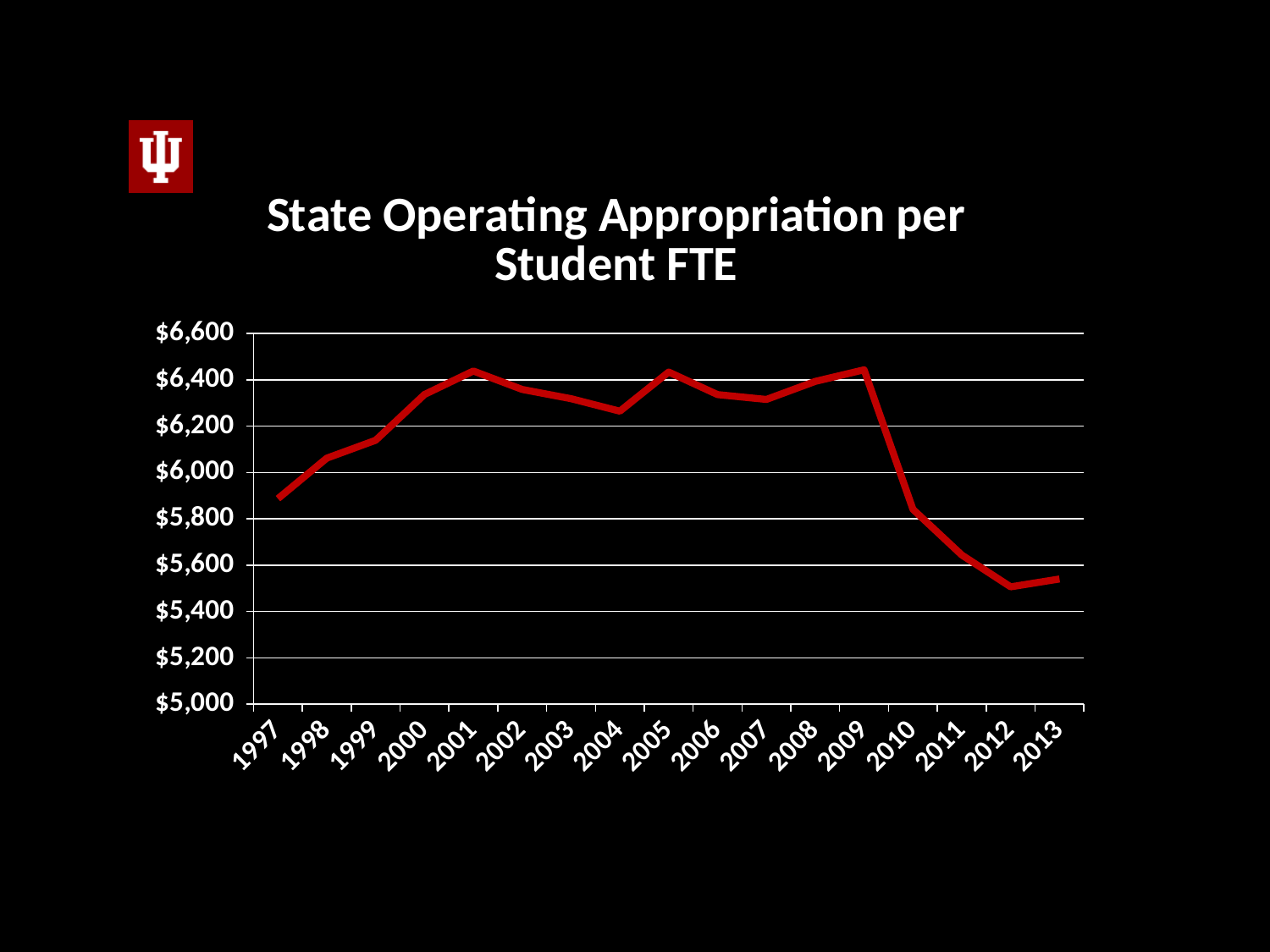
Is the value for 2012 greater or less than $5,600? less Is the value for 2010 greater or less than $6,000? less Is the value for 2001 greater or less than $6,400? greater Which year has the larger value, 1997 or 2001? 2001 What kind of chart is shown on the slide? line chart How many years are plotted along the x axis? 17 What is the title of the chart? State Operating Appropriation per Student FTE Which year has the larger value, 2009 or 2010? 2009 Which year has the lowest state operating appropriation per student FTE? 2012 Do the values rise or fall from 2009 to 2012? fall